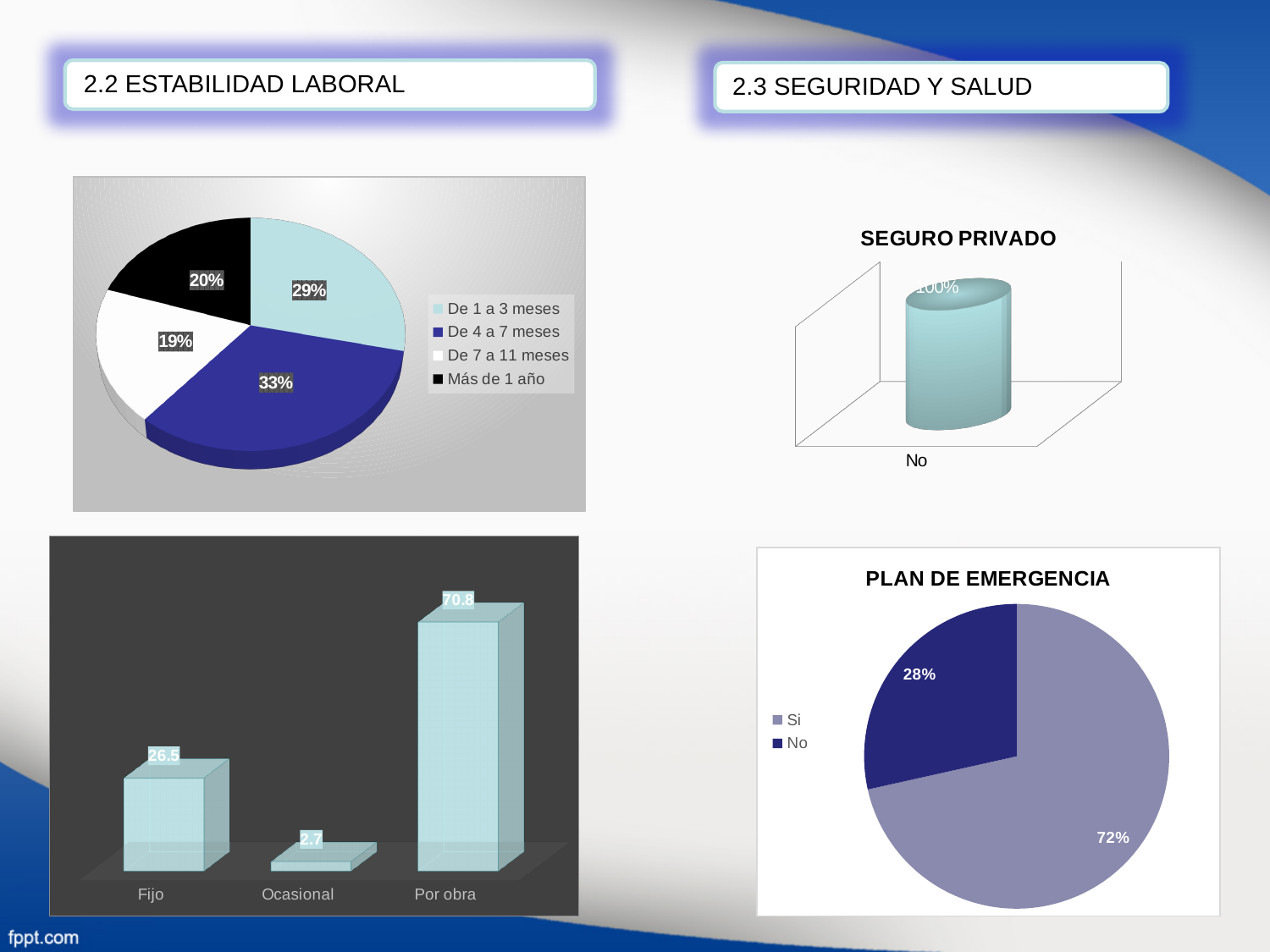
In the 'PLAN DE EMERGENCIA' pie chart, what share is labelled for 'No'? 28% In the top-left pie chart, which category has the smallest slice? De 7 a 11 meses In the bottom-left bar chart, what is the difference between 'Por obra' and 'Fijo'? 44.3 In the bottom-left bar chart, which category has the lowest value? Ocasional In the top-left pie chart, what share is labelled for 'De 4 a 7 meses'? 33% In the top-left pie chart, which category has the largest slice? De 4 a 7 meses In the top-left pie chart, how many categories does the legend list? 4 In the top-left pie chart, what is the difference between the 'De 1 a 3 meses' slice and the 'Más de 1 año' slice? 9% In the 'SEGURO PRIVADO' chart, what value is shown for 'No'? 100% What kind of chart is the bottom-left chart with Fijo, Ocasional and Por obra? Bar chart In the bottom-left bar chart, what is the value for 'Por obra'? 70.8 In the 'PLAN DE EMERGENCIA' pie chart, which is larger, 'Si' or 'No'? Si